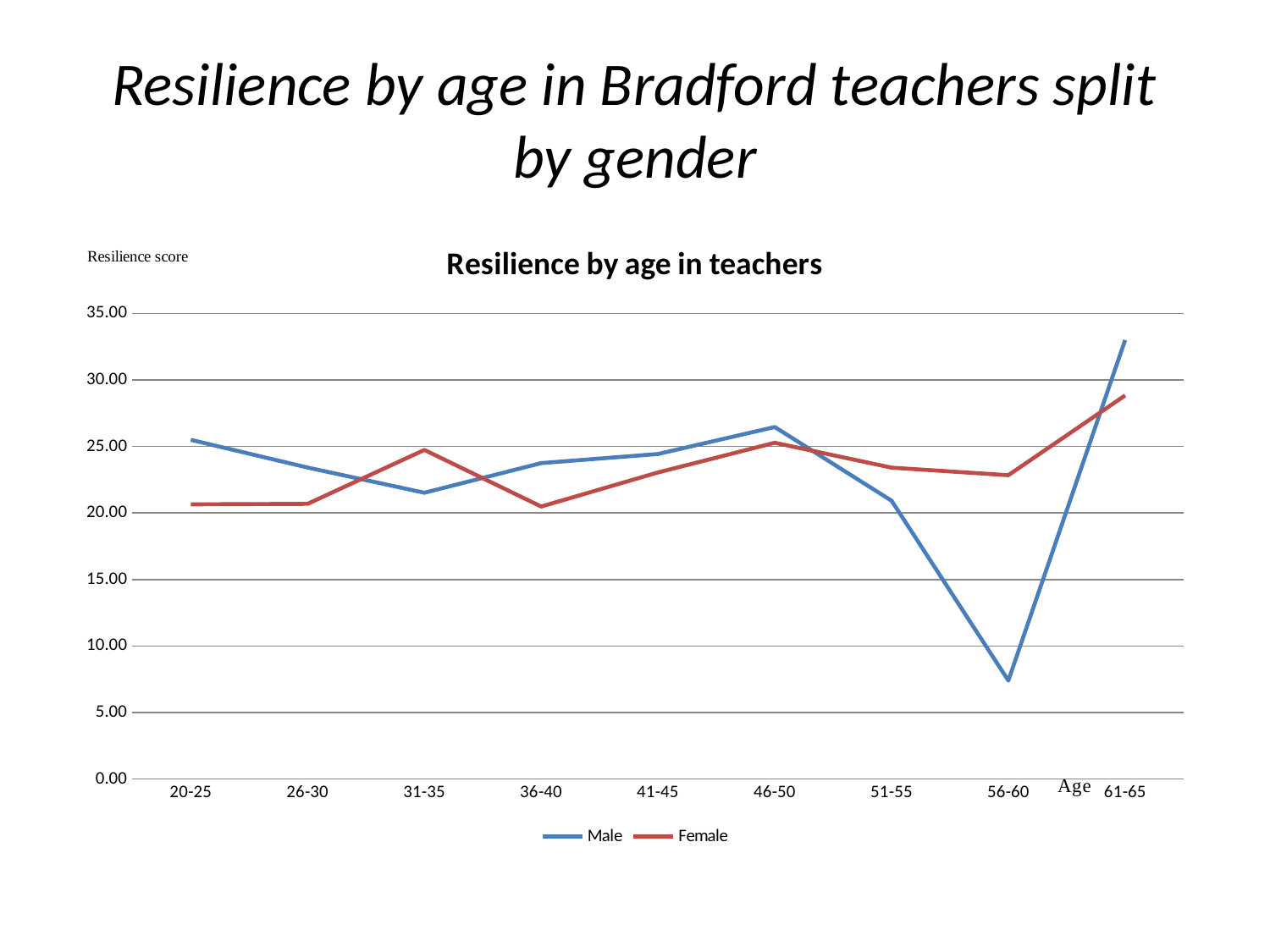
Does the Male line rise or fall from 46-50 to 56-60? Fall What kind of chart is shown on the slide? Line chart At age 56-60, which series has the higher resilience score, Male or Female? Female Which age group has the lowest Male resilience score? 56-60 How many series does the legend list? 2 Which age group has the highest Female resilience score? 61-65 Is the Male value for 61-65 greater or less than 30.00? greater Is the Male value for 56-60 greater or less than 10.00? less Is the Male value for 46-50 greater or less than 25.00? greater Which age group has the highest Male resilience score? 61-65 How many age groups are shown on the x axis? 9 What is the title printed above the chart? Resilience by age in teachers